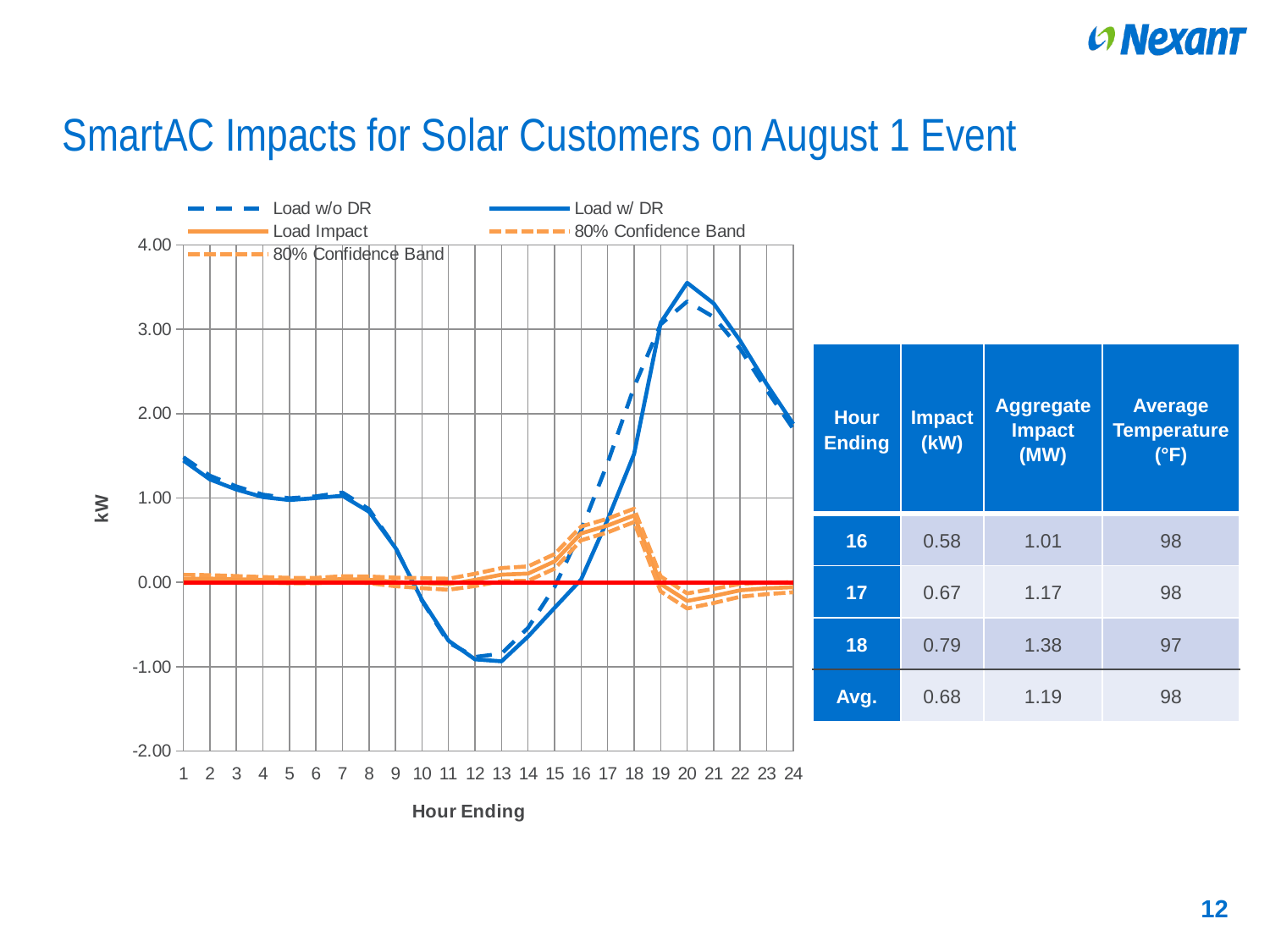
Does Load w/o DR rise or fall from hour ending 13 to hour ending 20? rise How many hours are shown along the x axis of the chart? 24 Is the value of Load Impact at hour ending 18 greater or less than 1.00? less What is the label on the chart's y axis? kW Is the value of Load w/ DR at hour ending 1 greater or less than 1.00? greater How many series does the chart's legend list? 5 At hour ending 17, which is larger, Load w/o DR or Load w/ DR? Load w/o DR Is the value of Load w/o DR at hour ending 13 greater or less than 0.00? less What kind of chart is shown on the slide? line chart Does Load w/ DR rise or fall from hour ending 20 to hour ending 24? fall At which hour ending does Load w/ DR reach its highest value? 20